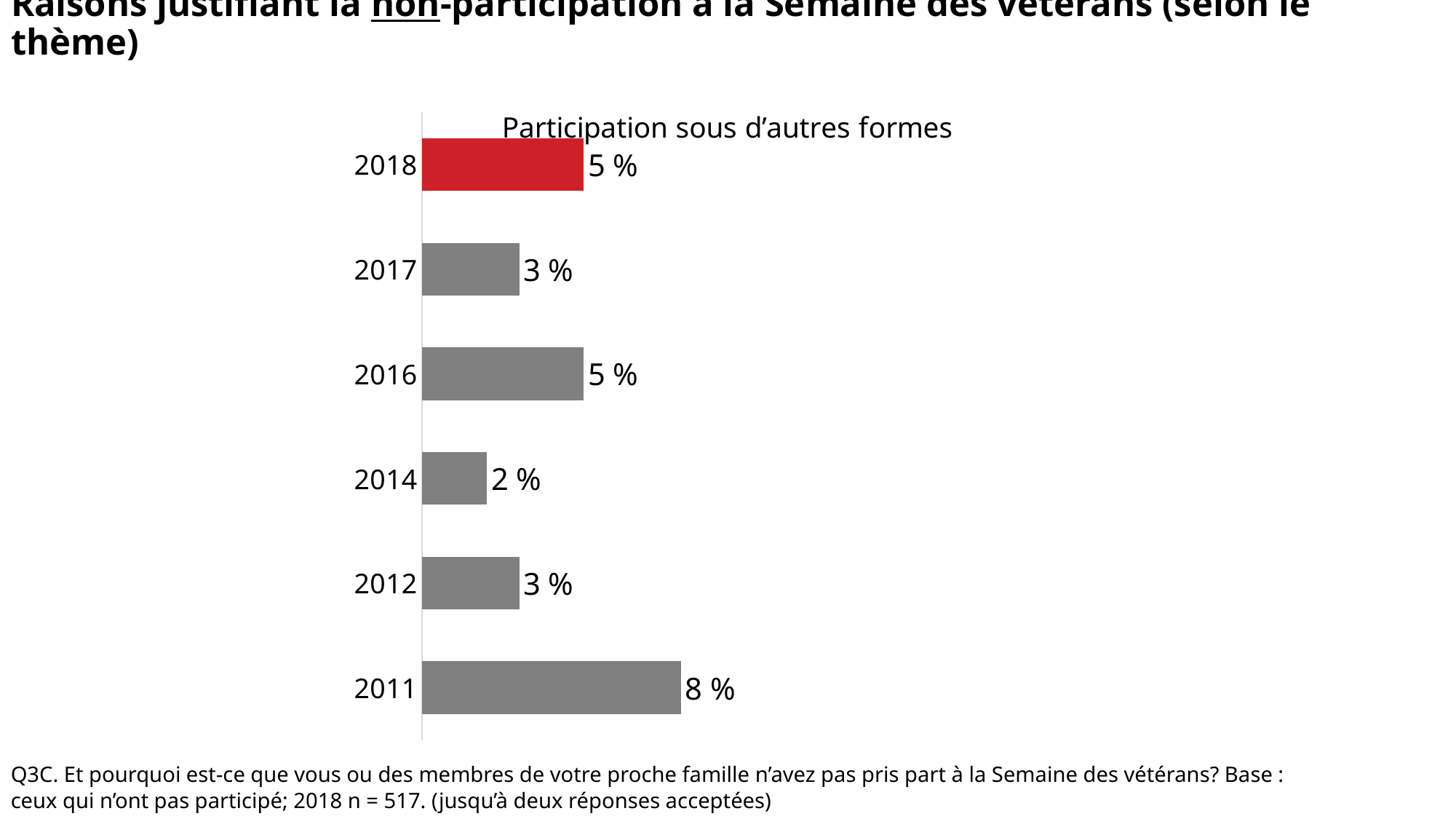
Which year's bar is coloured red? 2018 What is the title of the chart? Participation sous d’autres formes How many years are shown in the chart? 6 Which is larger, the value for 2016 or the value for 2012? 2016 What kind of chart is shown? Bar chart What is the value for 2014? 2 % What is the difference between the values for 2011 and 2018? 3 % Which year has the highest value? 2011 What is the value for 2018? 5 % What is the value for 2017? 3 % What is the value for 2011? 8 % Which year has the lowest value? 2014